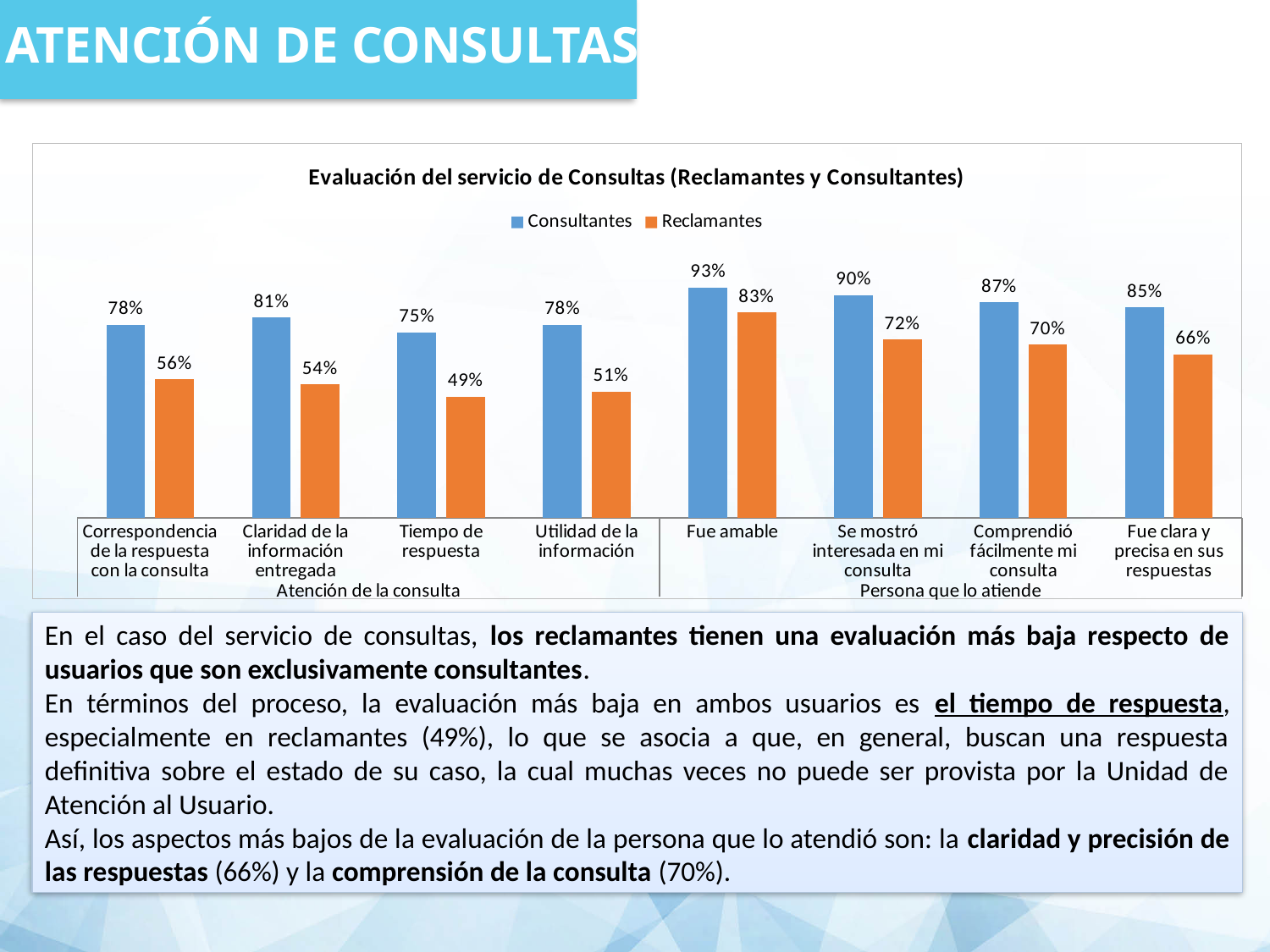
What is the Consultantes value for "Fue amable"? 93% How many series does the legend list? 2 What is the Reclamantes value for "Fue clara y precisa en sus respuestas"? 66% What is the title of the chart? Evaluación del servicio de Consultas (Reclamantes y Consultantes) Which category has the lowest Reclamantes value? Tiempo de respuesta How many categories are shown on the x axis? 8 What kind of chart is shown on the slide? Bar chart Which is larger: the Reclamantes value for "Fue amable" or the Reclamantes value for "Se mostró interesada en mi consulta"? Fue amable Which colour represents the Reclamantes series? Orange What is the difference between the Consultantes and Reclamantes values for "Claridad de la información entregada"? 27% Which category has the highest Consultantes value? Fue amable What is the Reclamantes value for "Tiempo de respuesta"? 49%